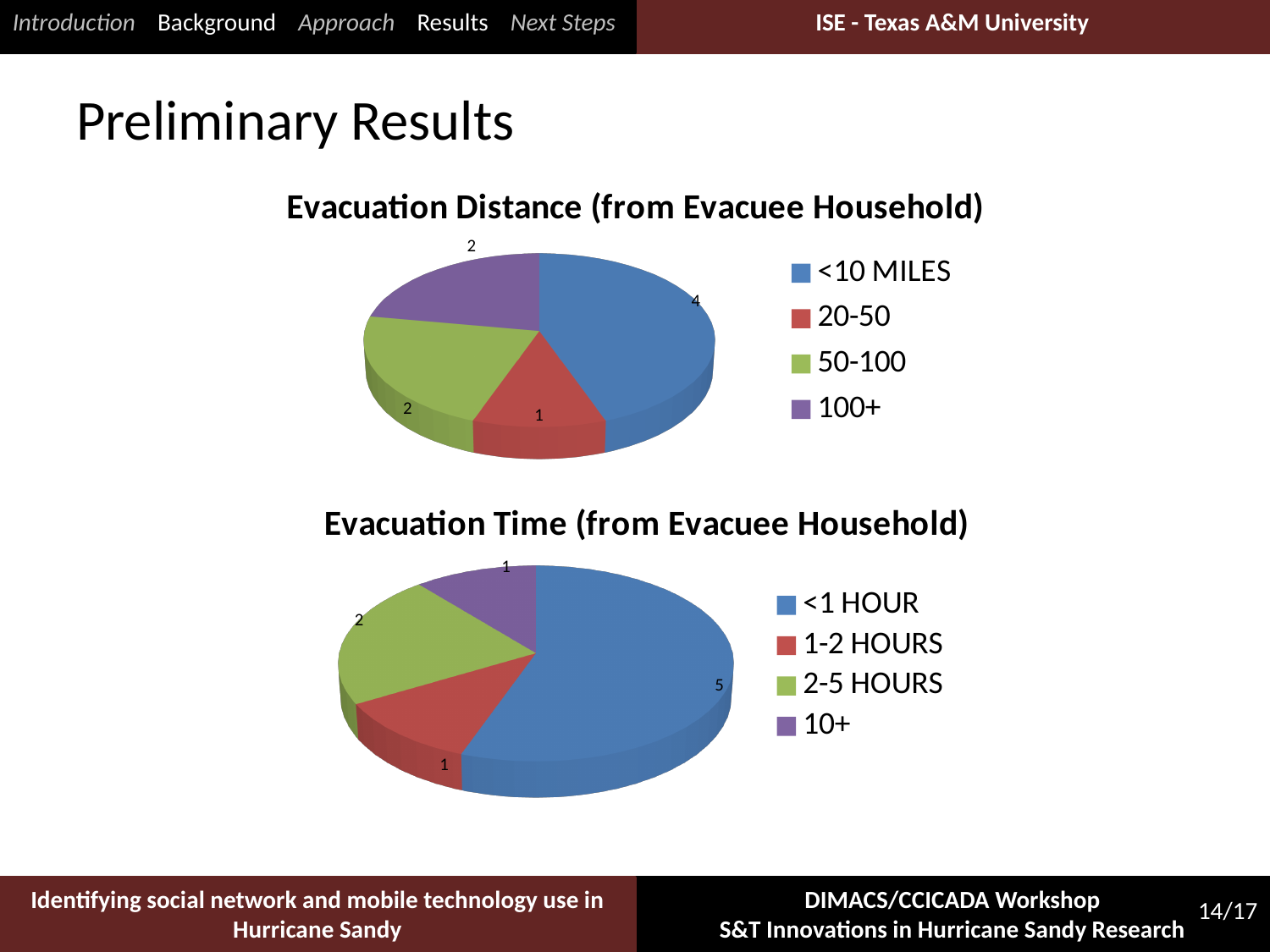
In the Evacuation Distance (from Evacuee Household) chart, what is the difference between the values for <10 MILES and 50-100? 2 In the Evacuation Distance (from Evacuee Household) chart, what is the value for 20-50? 1 In the Evacuation Time (from Evacuee Household) chart, what is the value for 2-5 HOURS? 2 In the Evacuation Distance (from Evacuee Household) chart, how many categories does the legend list? 4 In the Evacuation Time (from Evacuee Household) chart, which category has the largest value? <1 HOUR In the Evacuation Time (from Evacuee Household) chart, what colour is the slice for 1-2 HOURS? Red In the Evacuation Time (from Evacuee Household) chart, what is the value for <1 HOUR? 5 In the Evacuation Time (from Evacuee Household) chart, which is larger, the value for 2-5 HOURS or the value for 10+? 2-5 HOURS In the Evacuation Distance (from Evacuee Household) chart, what is the value for <10 MILES? 4 What type of chart is the Evacuation Time (from Evacuee Household) chart? Pie chart In the Evacuation Distance (from Evacuee Household) chart, which category has the largest value? <10 MILES In the Evacuation Distance (from Evacuee Household) chart, which category has the smallest value? 20-50